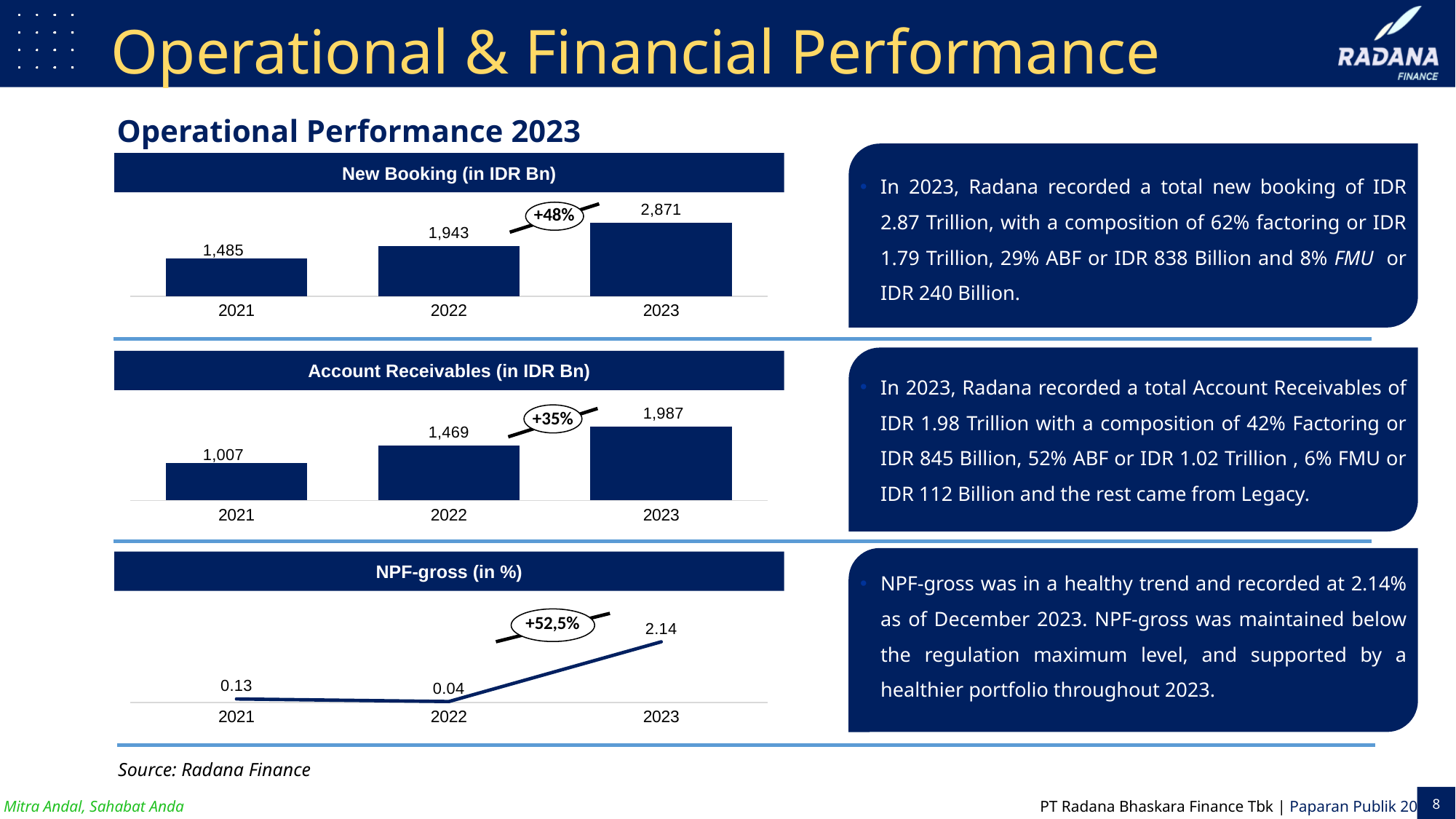
In the NPF-gross (in %) chart, which is larger, the value for 2021 or the value for 2022? 2021 In the New Booking (in IDR Bn) chart, what is the value for 2023? 2,871 In the New Booking (in IDR Bn) chart, do the values rise or fall from 2021 to 2023? rise What kind of chart is the NPF-gross (in %) chart? line chart In the Account Receivables (in IDR Bn) chart, which year has the highest value? 2023 In the New Booking (in IDR Bn) chart, which year has the lowest value? 2021 What kind of chart is the New Booking (in IDR Bn) chart? bar chart In the New Booking (in IDR Bn) chart, what is the difference between the 2023 and 2022 values? 928 In the NPF-gross (in %) chart, what is the value for 2022? 0.04 In the Account Receivables (in IDR Bn) chart, what is the difference between the 2022 and 2021 values? 462 In the Account Receivables (in IDR Bn) chart, what is the value for 2021? 1,007 How many years are shown on the x axis of the Account Receivables (in IDR Bn) chart? 3